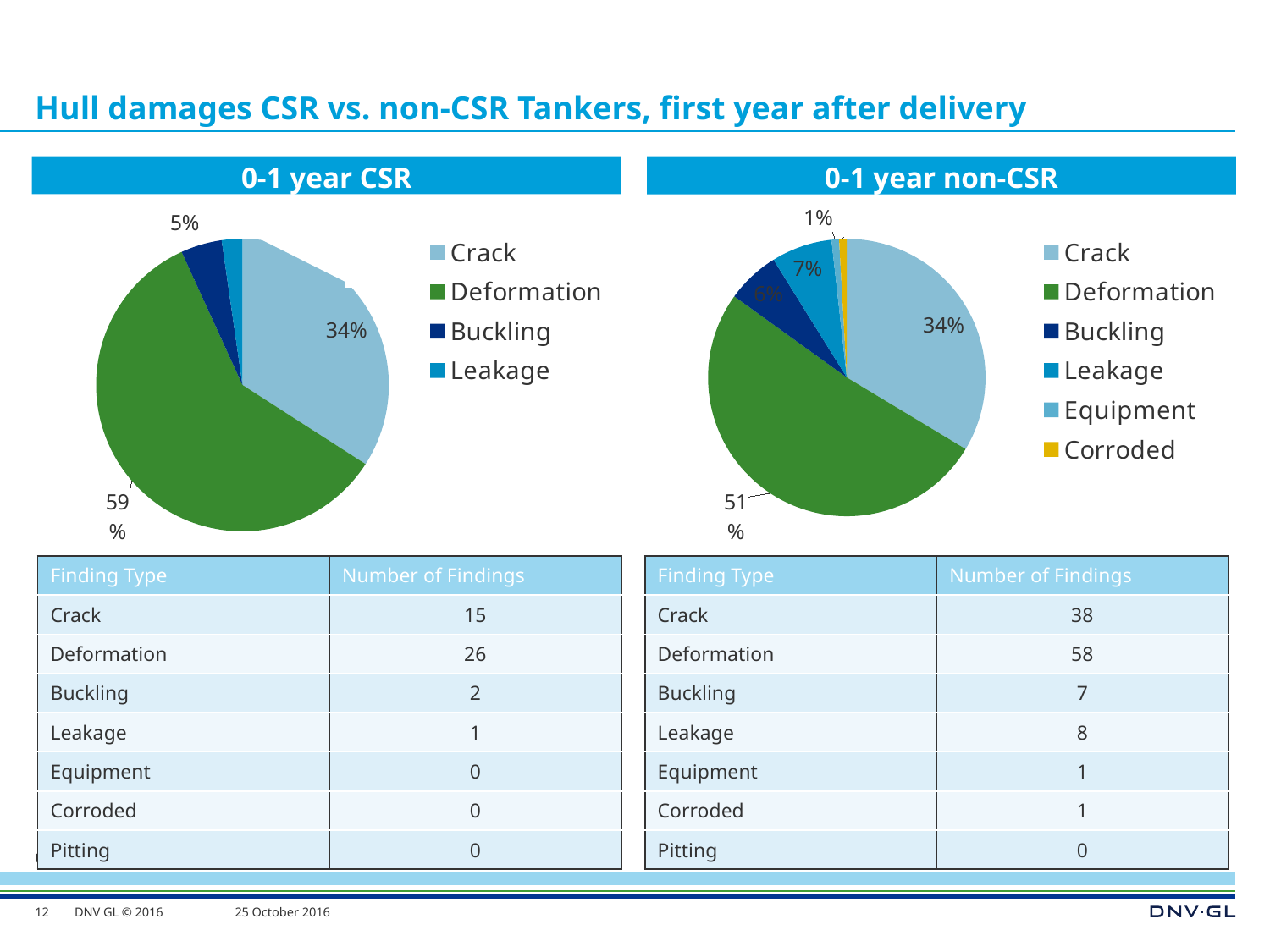
In the 0-1 year CSR pie chart, which finding type has the largest slice? Deformation In the 0-1 year non-CSR pie chart, which is larger, the Crack slice or the Leakage slice? Crack In the 0-1 year CSR pie chart, what share of findings is Deformation? 59% In the 0-1 year non-CSR pie chart, which finding type has the largest slice? Deformation In the 0-1 year non-CSR pie chart, what share of findings is Deformation? 51% In the 0-1 year CSR pie chart, what is the difference in percentage points between Deformation and Crack? 25% What kind of chart is used for the 0-1 year CSR data? Pie chart In the 0-1 year CSR pie chart, what share of findings is Crack? 34% In the 0-1 year CSR pie chart, which finding type has the smallest slice? Leakage How many entries does the legend of the 0-1 year non-CSR chart list? 6 In the 0-1 year non-CSR pie chart, what share of findings is Leakage? 7% In the 0-1 year CSR pie chart, what share of findings is Buckling? 5%